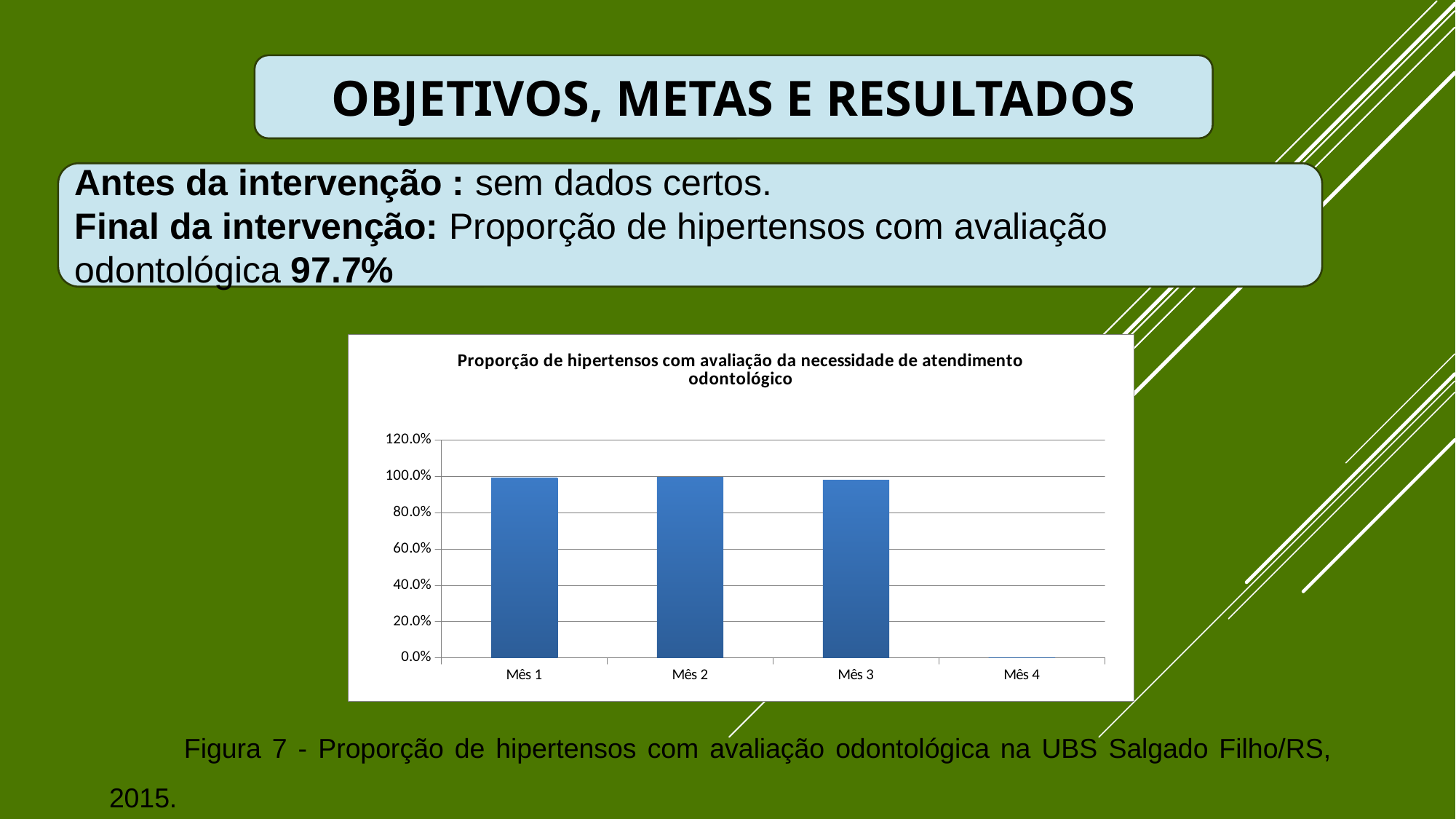
What kind of chart is shown on the slide? Bar chart How many categories are shown on the x axis of the chart? 4 Is the value for Mês 3 greater or less than 40.0%? greater What is the label of the first category on the x axis? Mês 1 Is the value for Mês 1 greater or less than 80.0%? greater Which is larger, the value for Mês 2 or the value for Mês 4? Mês 2 Which category has the lowest value in the chart? Mês 4 Is the value for Mês 2 greater or less than 60.0%? greater What is the title of the chart? Proporção de hipertensos com avaliação da necessidade de atendimento odontológico